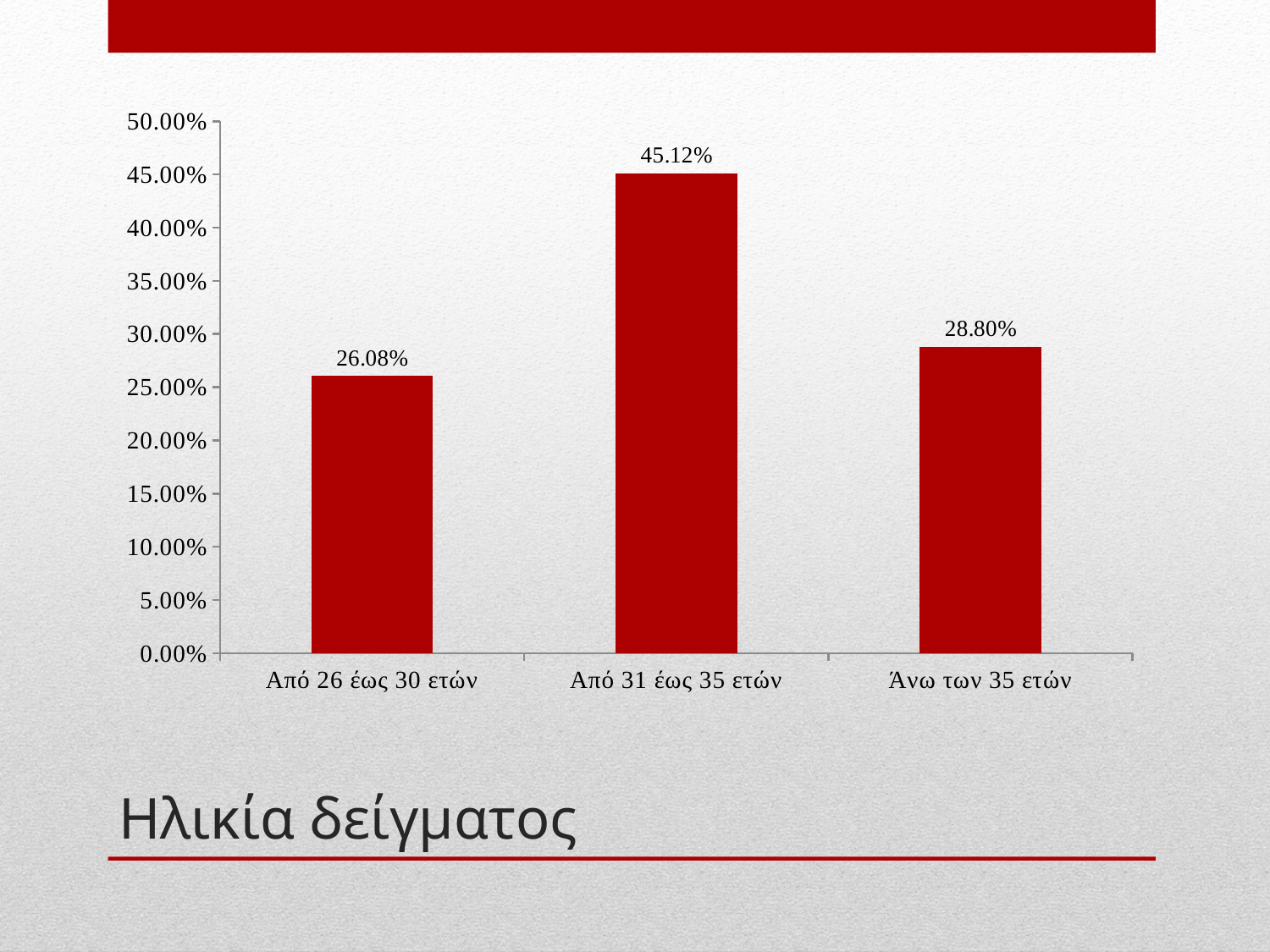
What is the value for Άνω των 35 ετών? 28.80% What is the title text shown below the chart? Ηλικία δείγματος Is the value for Από 31 έως 35 ετών greater or less than 40.00%? greater What kind of chart is shown on the slide? bar chart What is the value for Από 26 έως 30 ετών? 26.08% How many categories are shown on the x axis? 3 What is the value for Από 31 έως 35 ετών? 45.12% Which category has the highest value? Από 31 έως 35 ετών What is the difference between the values for Άνω των 35 ετών and Από 26 έως 30 ετών? 2.72% Which category has the lowest value? Από 26 έως 30 ετών Which is larger, the value for Από 26 έως 30 ετών or the value for Άνω των 35 ετών? Άνω των 35 ετών What is the difference between the values for Από 31 έως 35 ετών and Άνω των 35 ετών? 16.32%